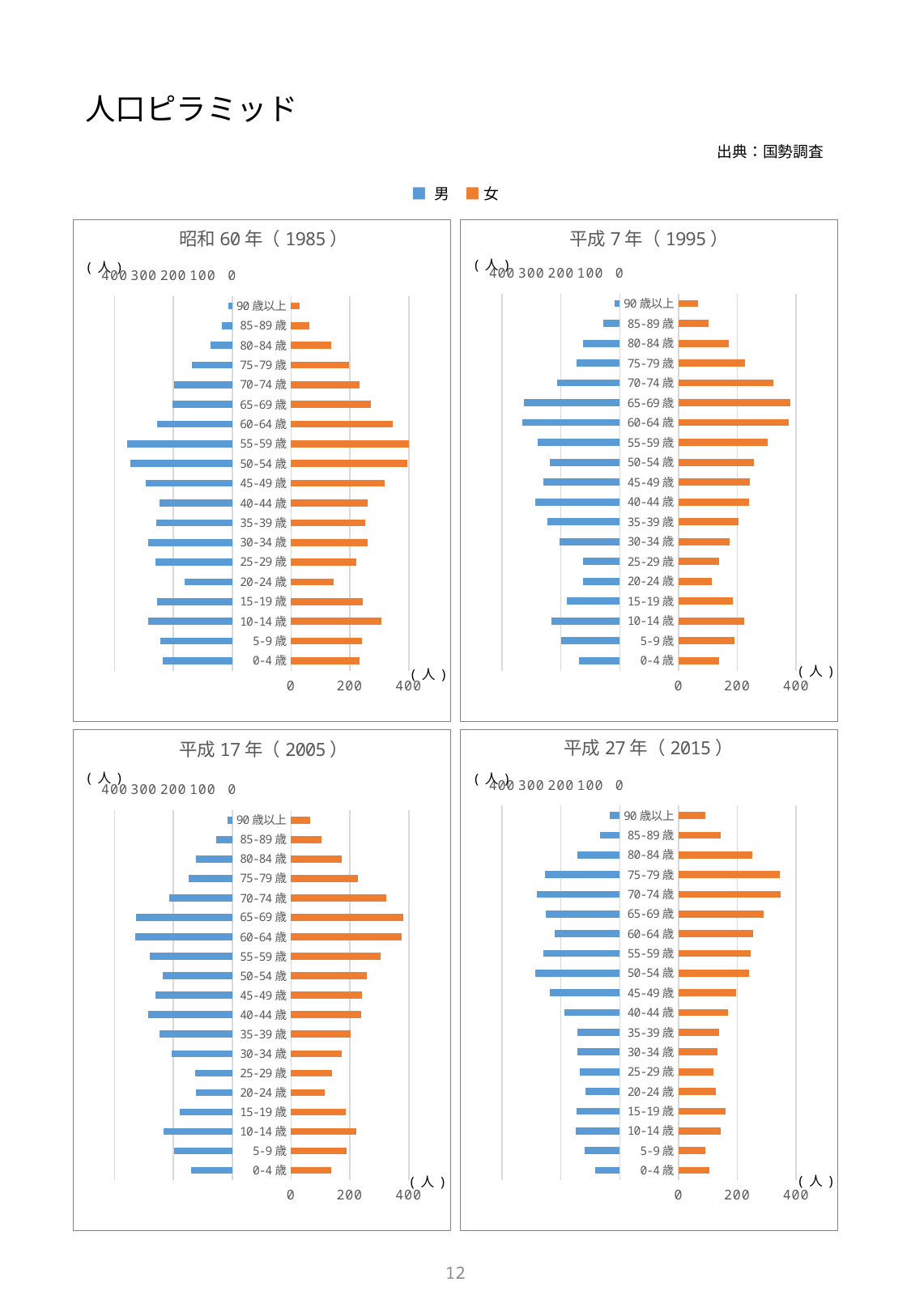
In the 平成27年（2015）chart, is the 男 value for 5-9歳 greater or less than 200? less In the 平成27年（2015）chart, which is larger for 男: 45-49歳 or 40-44歳? 45-49歳 How many age categories are shown in the 平成27年（2015）chart? 19 How many series does the shared legend list? 2 In the 平成17年（2005）chart, is the 女 value for 20-24歳 greater or less than 200? less Which colour represents 女 in the legend? orange How many charts are on the slide? 4 What kind of chart is the 昭和60年（1985）chart? bar chart In the 平成7年（1995）chart, is the 女 value for 65-69歳 greater or less than 300? greater